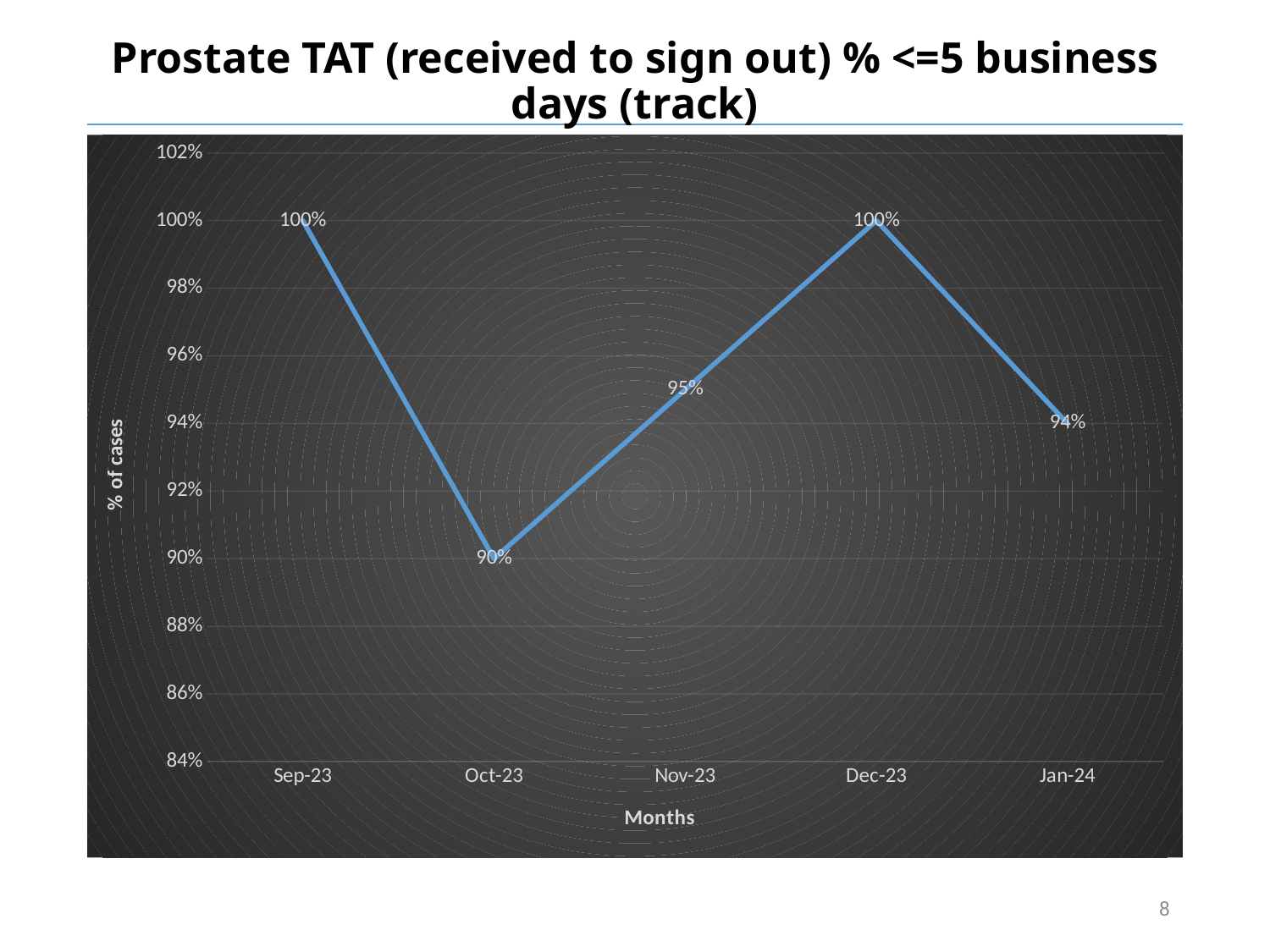
What is the value for Dec-23? 100% What is the difference between the values for Sep-23 and Oct-23? 10% Does the value rise or fall from Dec-23 to Jan-24? Fall What is the value for Nov-23? 95% What is the value for Oct-23? 90% What is the label of the vertical axis? % of cases What kind of chart is shown? Line chart What is the value for Jan-24? 94% What is the difference between the values for Nov-23 and Jan-24? 1% How many months are plotted on the chart? 5 Which is larger, the value for Nov-23 or the value for Jan-24? Nov-23 Which month has the lowest value? Oct-23